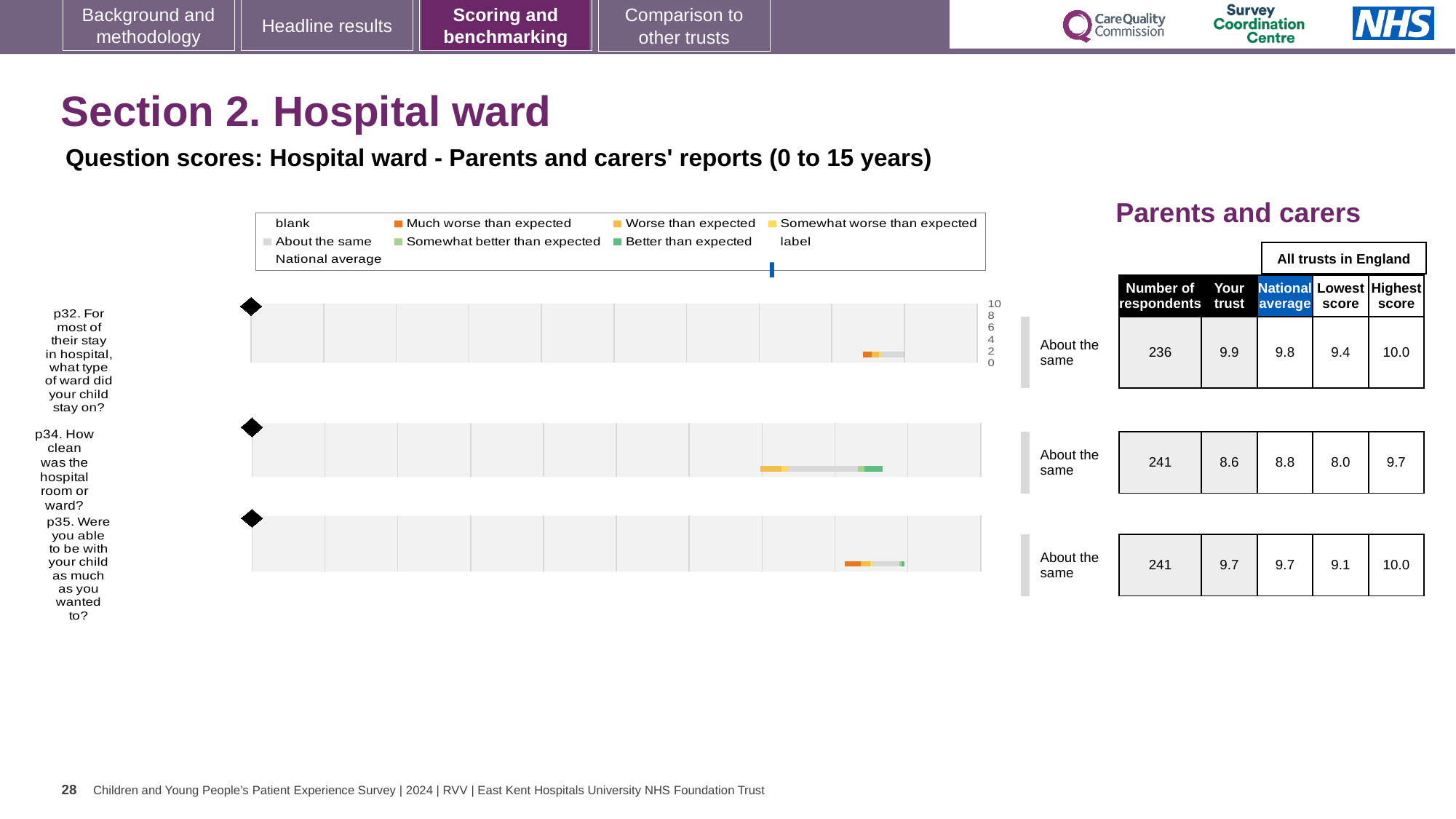
What is the national average score for p32 (For most of their stay in hospital, what type of ward did your child stay on?)? 9.8 How many respondents answered p35 (Were you able to be with your child as much as you wanted to?)? 241 For p34, which is larger: the 'Your trust' score or the national average? National average In the legend, what colour represents 'Better than expected'? Green How many survey questions are charted on the slide? 3 What benchmark category is shown for p32? About the same What is the 'Your trust' score for p34 (How clean was the hospital room or ward?)? 8.6 For p34, what is the difference between the highest score and the lowest score across all trusts in England? 1.7 Which question has the highest 'Your trust' score? p32 Which question has the lowest 'Your trust' score? p34 What is the lowest score across all trusts in England for p35? 9.1 What kind of chart is used for each question on the slide? bar chart